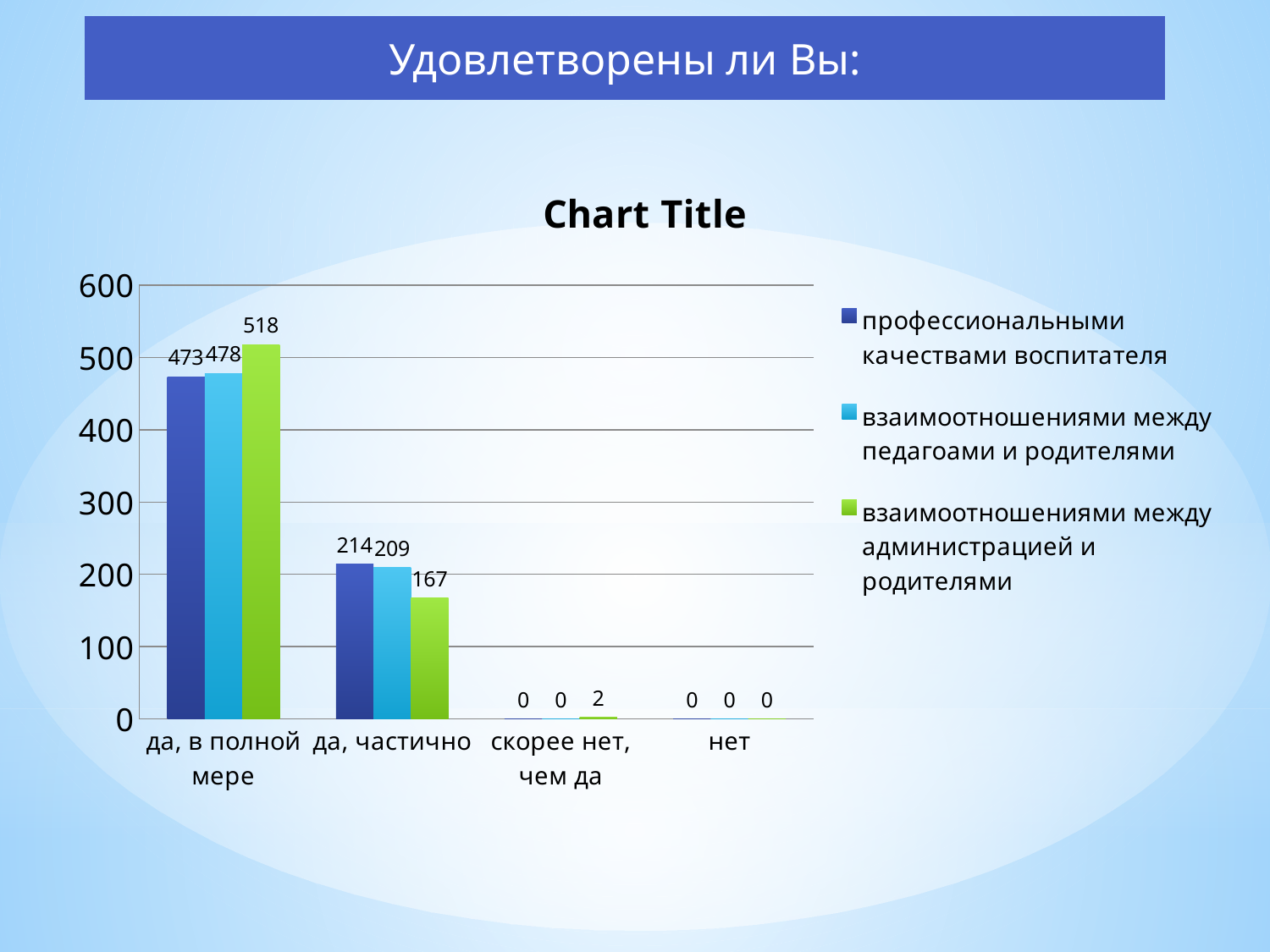
What is the value for "профессиональными качествами воспитателя" in the "да, в полной мере" category? 473 What is the value for "взаимоотношениями между администрацией и родителями" in the "да, частично" category? 167 What is the title shown above the chart? Chart Title How many categories are shown on the x axis? 4 What is the value for "взаимоотношениями между администрацией и родителями" in the "скорее нет, чем да" category? 2 Which series has the highest value in the "да, в полной мере" category? взаимоотношениями между администрацией и родителями Which series has the lowest value in the "да, частично" category? взаимоотношениями между администрацией и родителями How many series does the legend list? 3 Which is larger for "профессиональными качествами воспитателя": the value for "да, в полной мере" or for "да, частично"? да, в полной мере What is the value for "взаимоотношениями между педагоами и родителями" in the "да, частично" category? 209 What kind of chart is shown on the slide? bar chart What is the difference between the "да, в полной мере" and "да, частично" values for "взаимоотношениями между администрацией и родителями"? 351